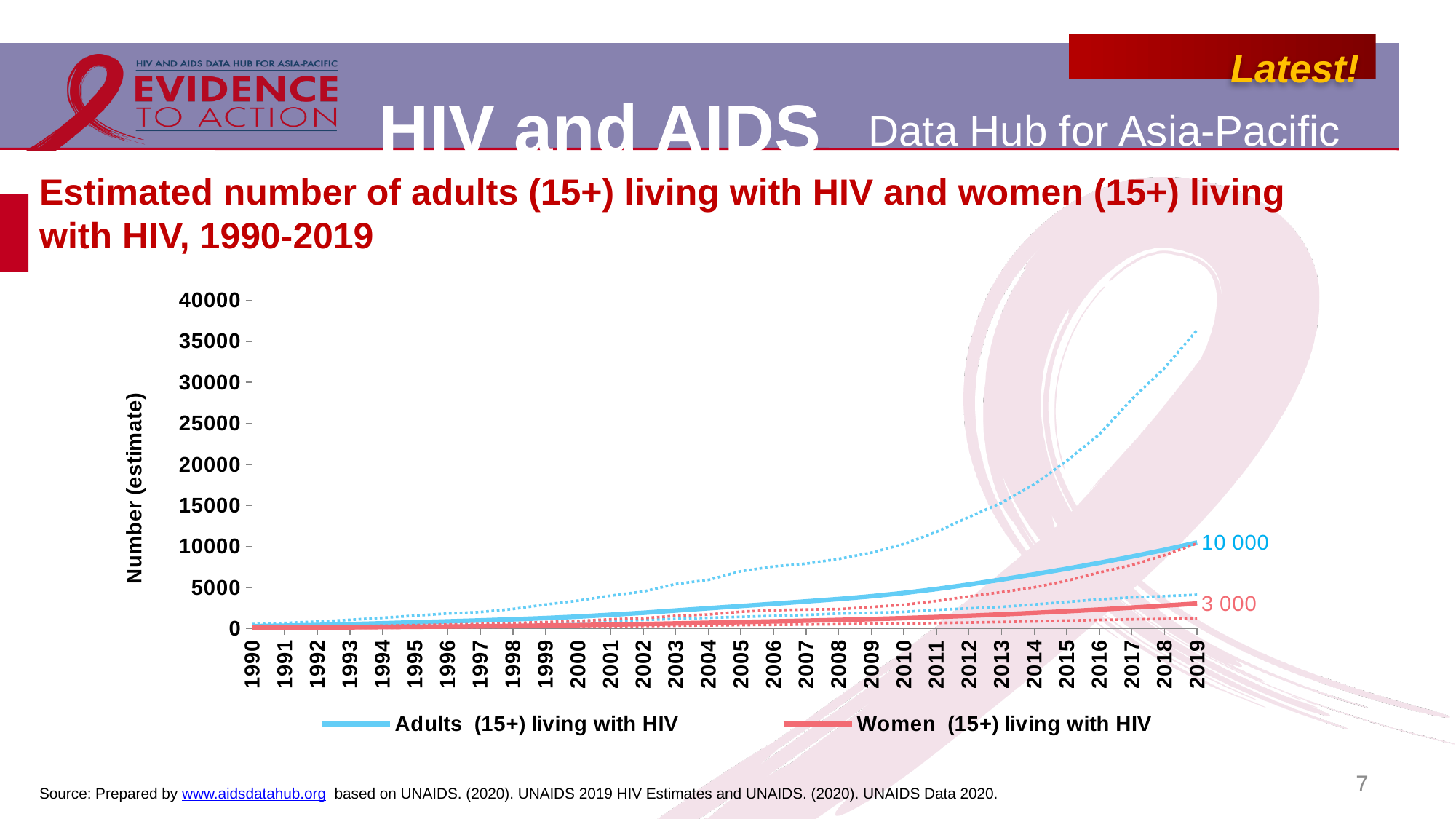
How many years are shown on the x axis? 30 In 2019, which is larger: the number of adults (15+) living with HIV or the number of women (15+) living with HIV? Adults (15+) living with HIV How many series does the legend list? 2 What kind of chart is shown on the slide? Line chart What colour is the line for women (15+) living with HIV? Red What is the estimated number of women (15+) living with HIV in 2019? 3 000 What is the estimated number of adults (15+) living with HIV in 2019? 10 000 What is the title of the y axis? Number (estimate) What is the difference between the number of adults (15+) living with HIV and women (15+) living with HIV in 2019? 7 000 Does the number of adults (15+) living with HIV rise or fall from 1990 to 2019? Rise Is the value for women (15+) living with HIV in 2015 greater or less than 5000? less